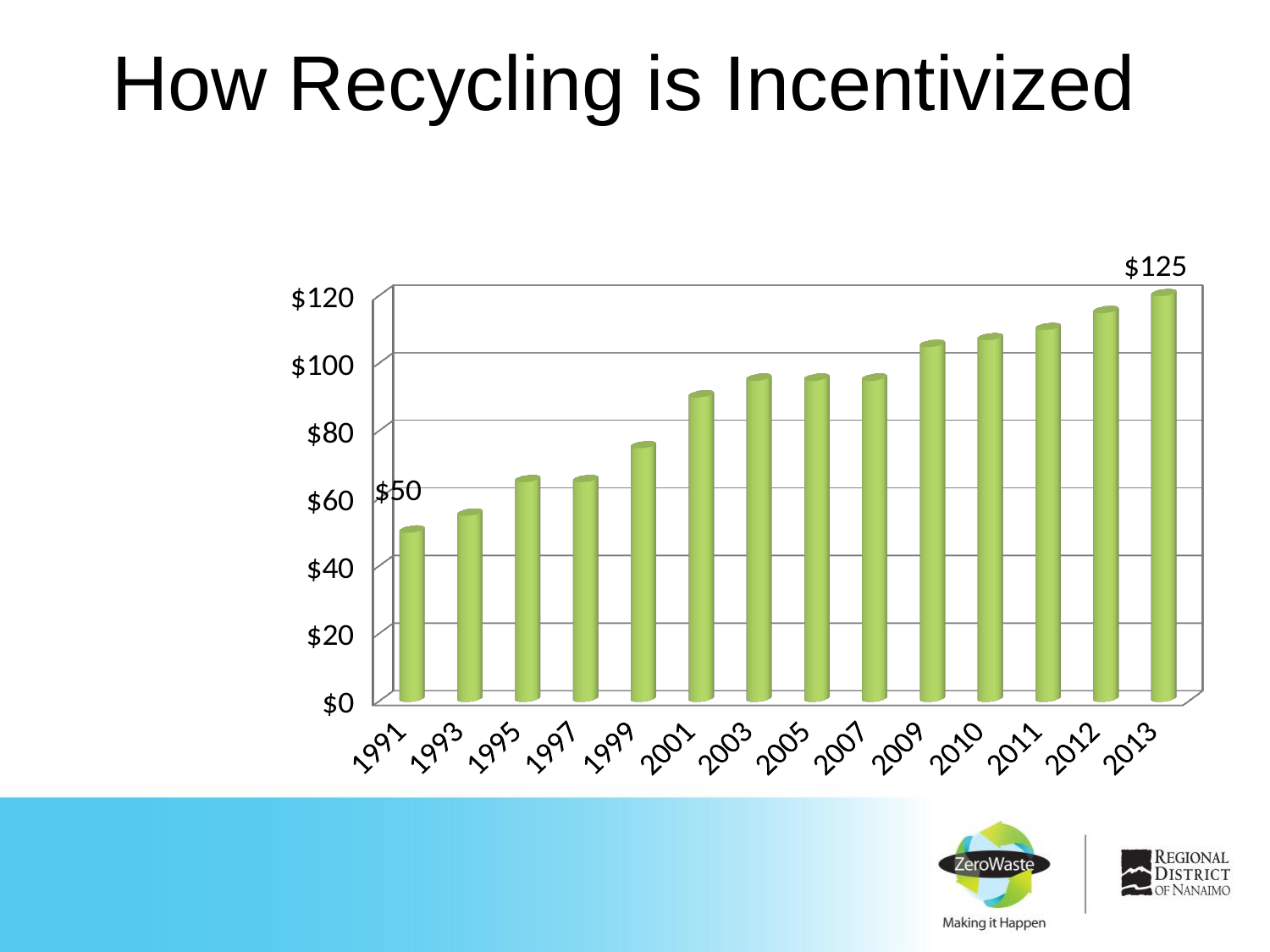
What is the value shown for 1991? $50 Is the value for 1997 greater or less than $80? less What is the value shown for 2013? $125 Is the value for 2001 greater or less than $80? greater What kind of chart is shown on the slide? Bar chart Which is larger, the value for 2003 or the value for 1993? 2003 What is the title of the slide containing the chart? How Recycling is Incentivized Do the values generally rise or fall from 1991 to 2013? Rise Which year has the lowest value? 1991 What is the difference between the value for 2013 and the value for 1991? $75 How many years are shown on the x axis? 14 Which year has the highest value? 2013